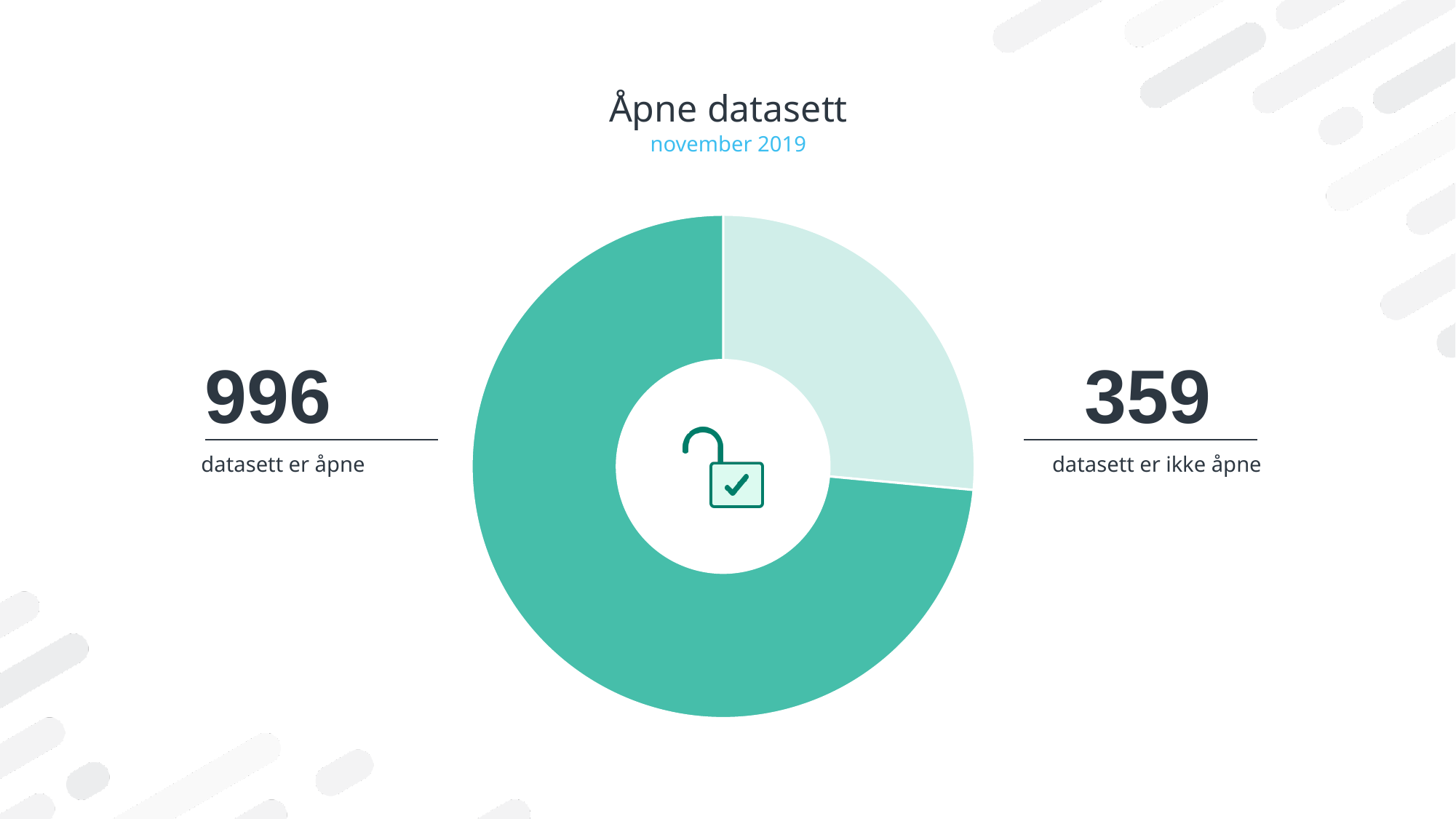
What is the difference between the number of open datasets and the number of not-open datasets? 637 Which category has the smaller value in the chart? datasett er ikke åpne How many datasets are open ("datasett er åpne") according to the chart? 996 What is the title of the chart? Åpne datasett Which month and year does the chart refer to? november 2019 What is the total number of datasets represented in the chart? 1355 Which category has the larger value: open datasets or not-open datasets? datasett er åpne Is the value for open datasets larger or smaller than the value for not-open datasets? larger How many categories does the chart show? 2 How many datasets are not open ("datasett er ikke åpne") according to the chart? 359 What kind of chart is shown on the slide? pie chart (donut)